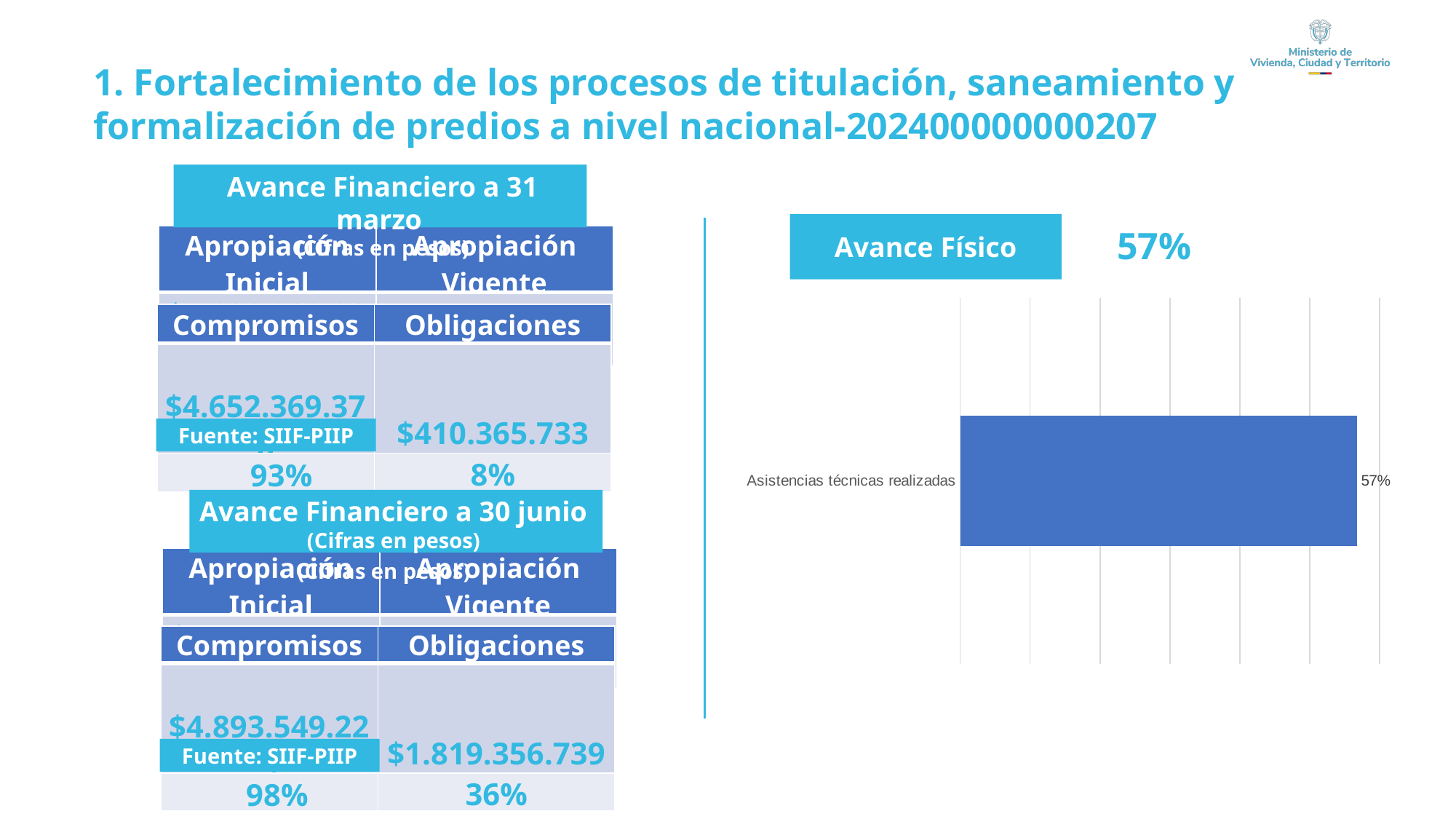
What is the label of the only category plotted in the Avance Físico chart? Asistencias técnicas realizadas What kind of chart is used to show the Avance Físico? Bar chart What is the title shown above the bar chart on the right of the slide? Avance Físico What is the value shown for "Asistencias técnicas realizadas" in the Avance Físico chart? 57% How many categories are plotted in the Avance Físico chart? 1 Are the bars in the Avance Físico chart horizontal or vertical? Horizontal